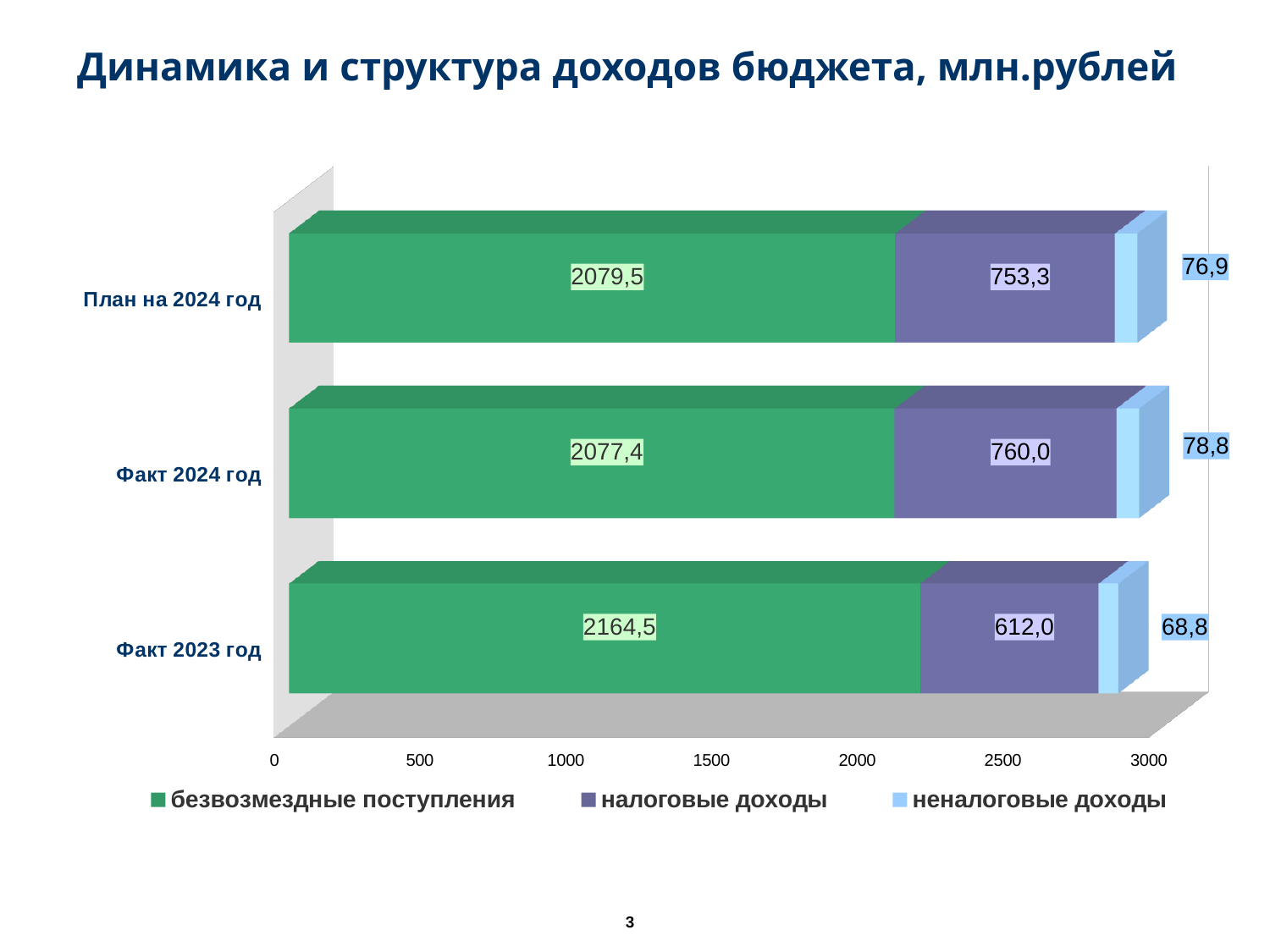
Which category has the lowest value for налоговые доходы? Факт 2023 год What is the value of безвозмездные поступления for План на 2024 год? 2079,5 Which category has the highest value for безвозмездные поступления? Факт 2023 год How many series does the legend list? 3 What is the value of неналоговые доходы for Факт 2023 год? 68,8 Which is larger: неналоговые доходы for План на 2024 год or for Факт 2024 год? Факт 2024 год What is the difference in налоговые доходы between Факт 2024 год and Факт 2023 год? 148,0 What is the total of the stacked bar for Факт 2023 год? 2845,3 What is the total of the stacked bar for Факт 2024 год? 2916,2 How many categories are shown on the chart? 3 What is the value of налоговые доходы for Факт 2024 год? 760,0 What kind of chart is shown on the slide? Stacked bar chart